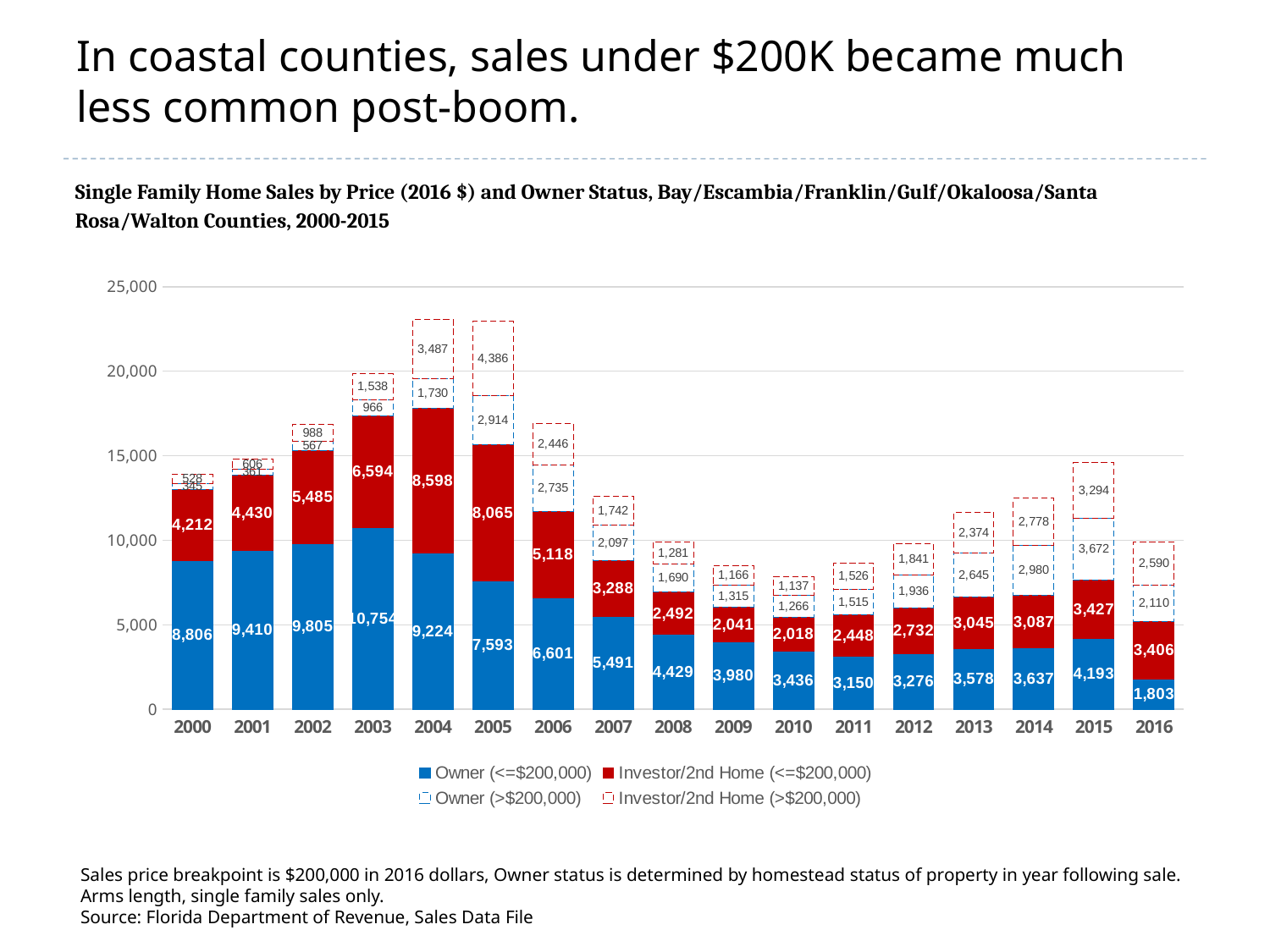
How many years are shown on the x axis? 17 Which year has the highest value for Owner (<=$200,000)? 2003 Which year has the lowest value for Owner (<=$200,000)? 2016 What kind of chart is shown on the slide? Stacked bar chart What is the value for Owner (<=$200,000) in 2003? 10,754 In 2005, which is larger: Owner (<=$200,000) or Investor/2nd Home (<=$200,000)? Investor/2nd Home (<=$200,000) What is the difference between the Owner (<=$200,000) values in 2003 and 2016? 8,951 What is the total of the stacked bar for 2016? 9,909 What is the value for Investor/2nd Home (<=$200,000) in 2005? 8,065 How many series does the legend list? 4 Does the value for Owner (<=$200,000) rise or fall from 2003 to 2010? Fall What is the value for Investor/2nd Home (>$200,000) in 2015? 3,294